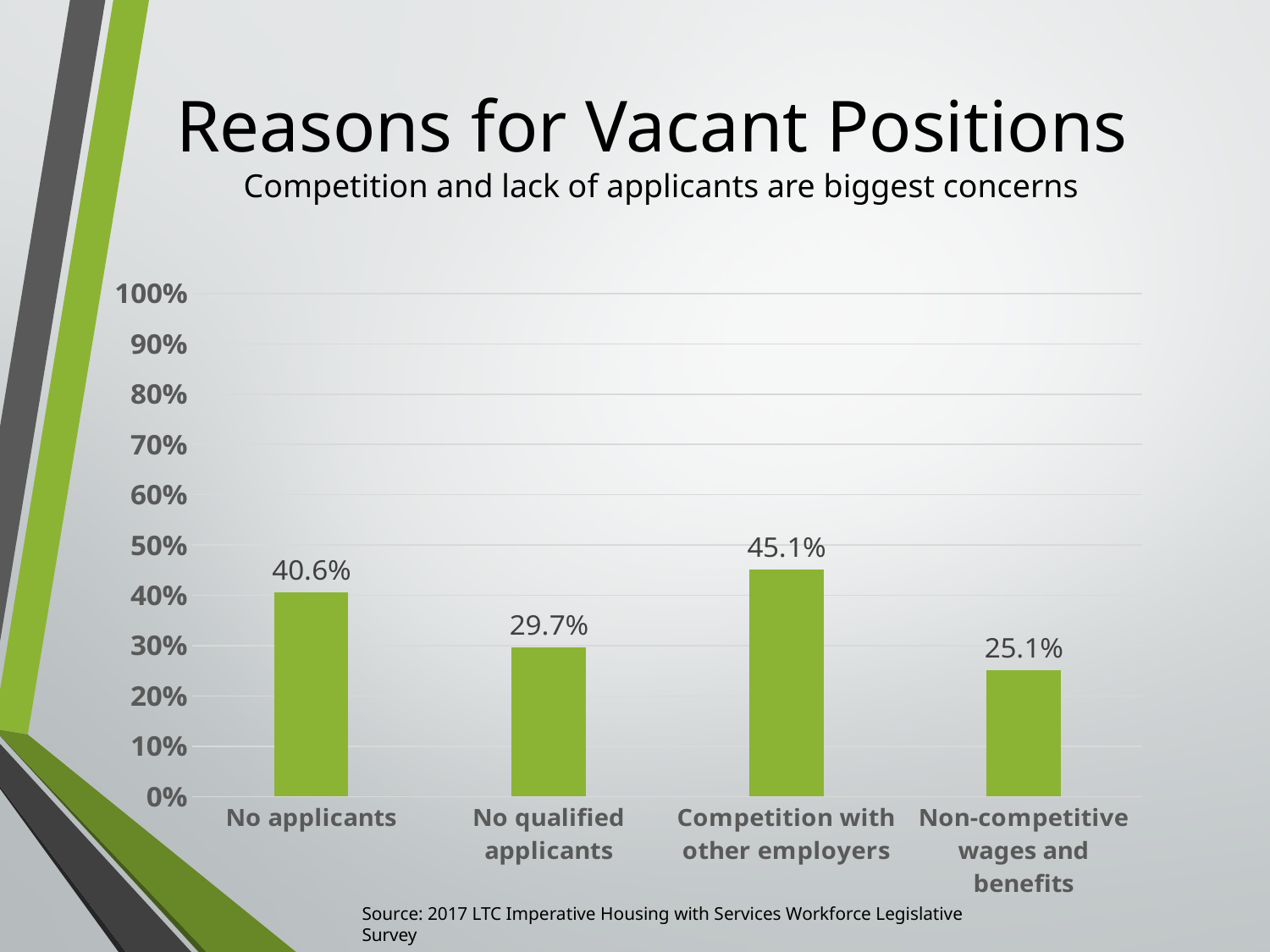
Is the value for No qualified applicants greater or less than 40%? less What is the value for No applicants? 40.6% What kind of chart is shown on the slide? bar chart What is the difference between the values for Competition with other employers and No applicants? 4.5% Which reason has the lowest value? Non-competitive wages and benefits Which reason has the highest value? Competition with other employers What is the title of the slide? Reasons for Vacant Positions What is the difference between the values for No qualified applicants and Non-competitive wages and benefits? 4.6% How many reasons are shown on the chart? 4 What is the value for Competition with other employers? 45.1% What is the value for Non-competitive wages and benefits? 25.1% Which is larger, the value for No qualified applicants or the value for Non-competitive wages and benefits? No qualified applicants